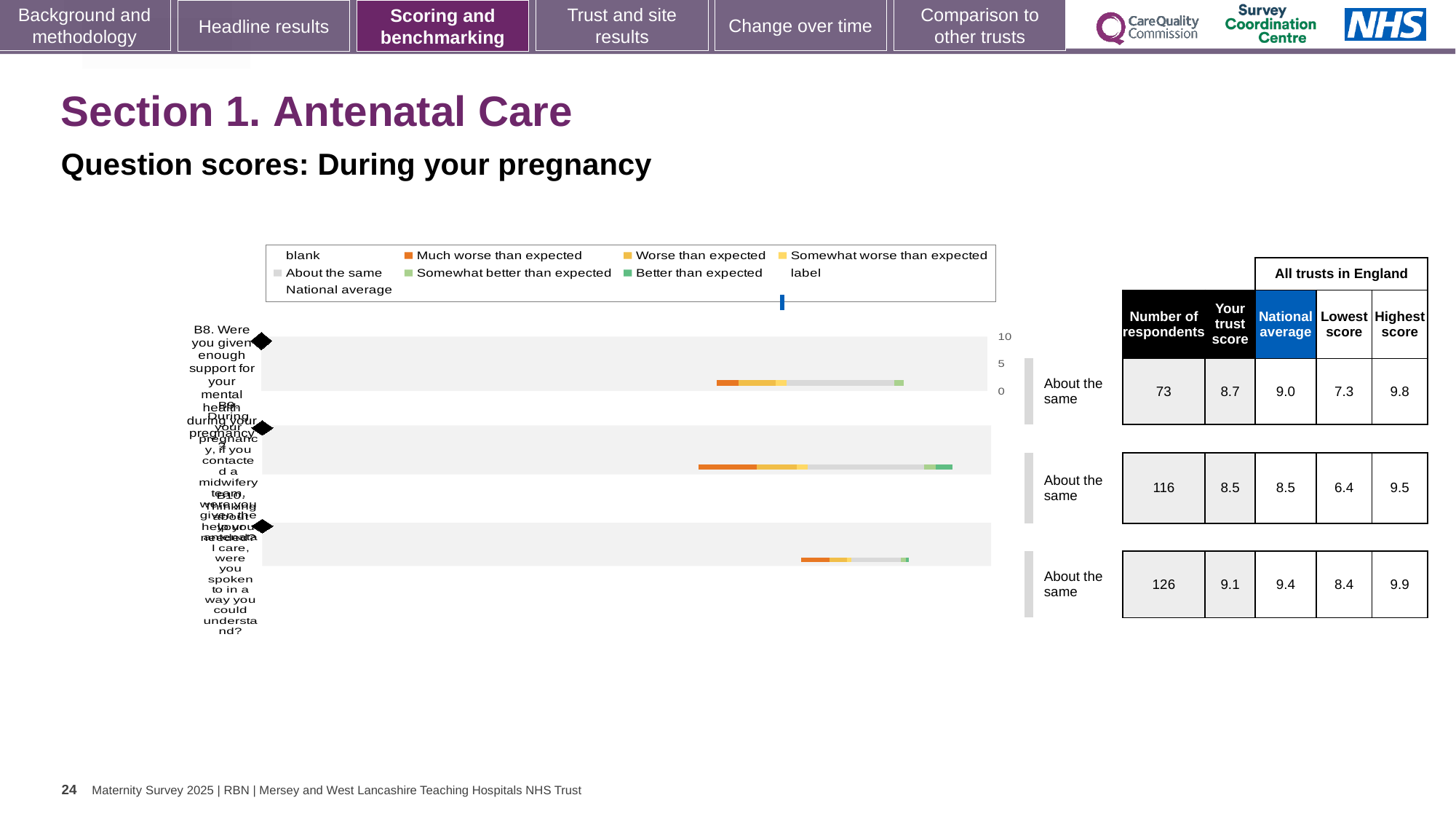
Which row of the chart has the largest number of respondents? the bottom row (126) What is the difference between the national average and the trust score for the top row (B8)? 0.3 What kind of chart is shown on the slide? bar chart What benchmark category is shown for each of the three rows in the chart? About the same What is the lowest score among all trusts in England for the middle row of the chart? 6.4 For the bottom row of the chart, which is larger: the trust score or the national average? the national average (9.4) How many survey questions (rows) are plotted in the chart? 3 What is the trust score for the bottom row of the chart? 9.1 How many respondents answered the top row question (B8)? 73 What is the national average for the top row (B8)? 9.0 What is the trust score for the top row (B8, support for your mental health during pregnancy)? 8.7 What is the highest score among all trusts in England for the bottom row of the chart? 9.9